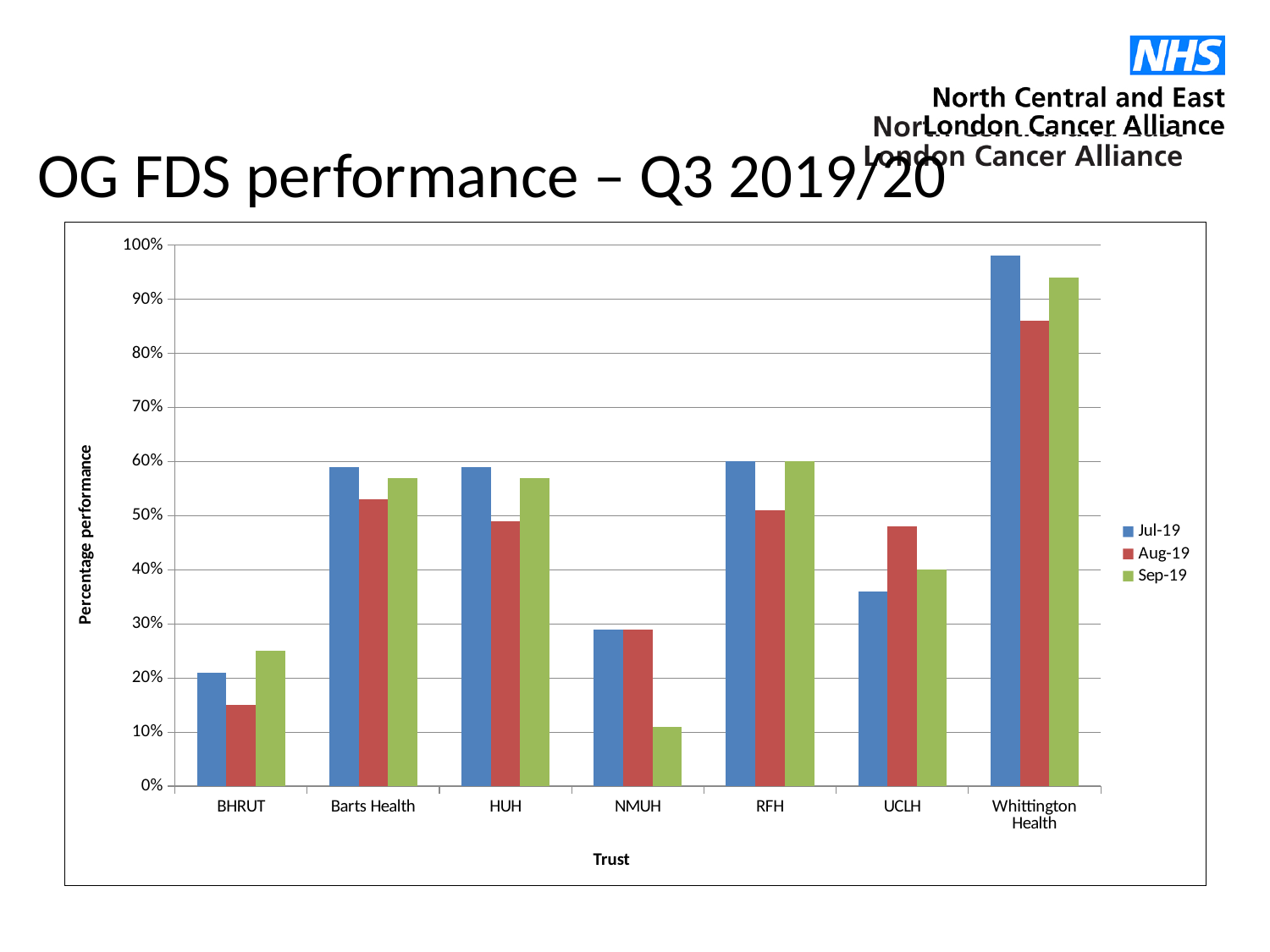
How many series does the chart's legend list? 3 Which trust has the highest Jul-19 value? Whittington Health What kind of chart is shown on the slide? bar chart Is the Jul-19 value for Whittington Health greater or less than 90%? greater For BHRUT, which is larger: the Aug-19 value or the Sep-19 value? Sep-19 Is the Sep-19 value for NMUH greater or less than 20%? less What is the label on the y axis of the chart? Percentage performance Is the Aug-19 value for UCLH greater or less than 40%? greater Which trust has the lowest Aug-19 value? BHRUT Which trust has the lowest Sep-19 value? NMUH For UCLH, which is larger: the Jul-19 value or the Aug-19 value? Aug-19 How many trusts are shown on the x axis of the chart? 7